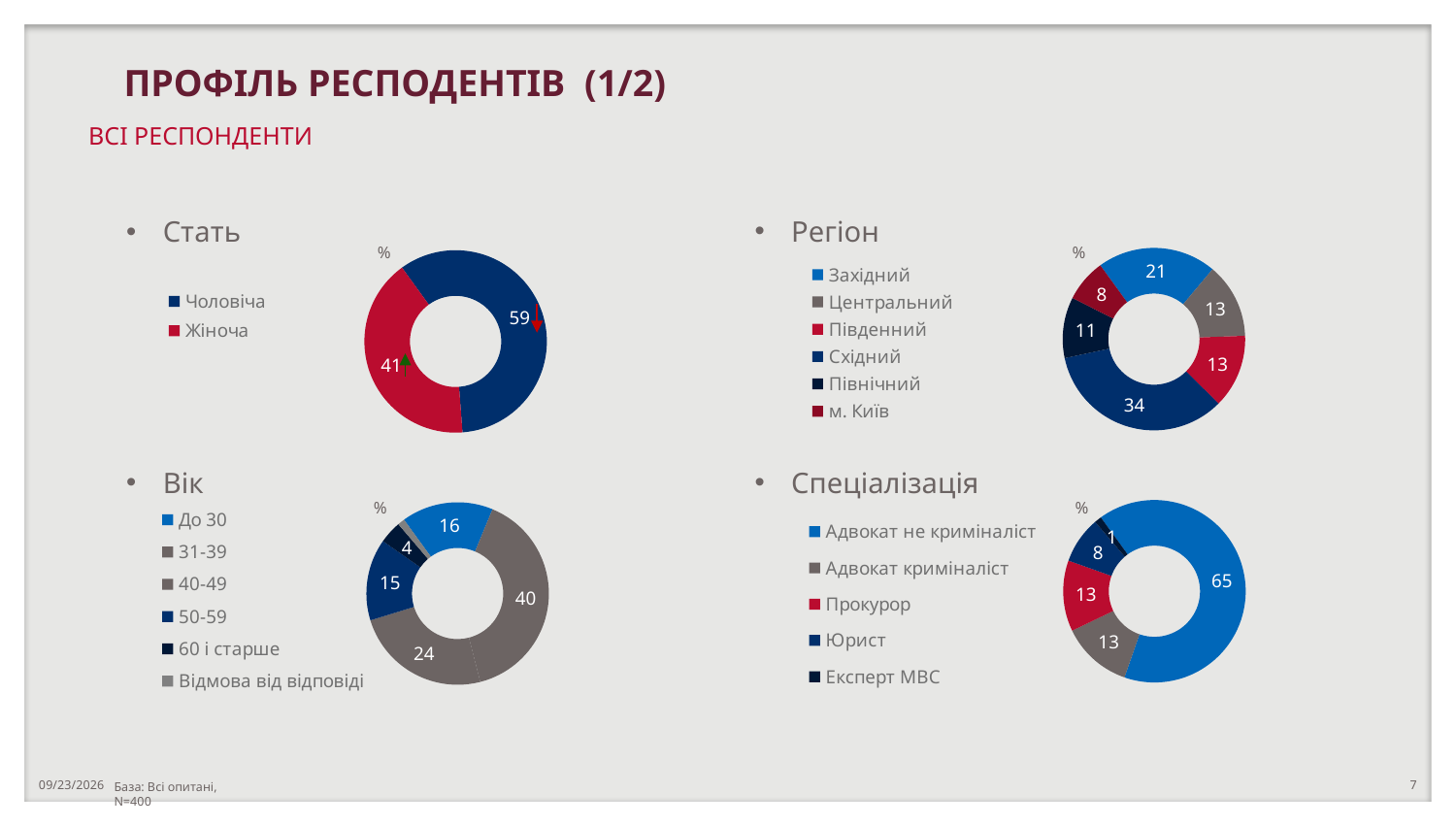
How many entries does the legend of the Вік chart list? 6 In the Регіон chart, which region has the highest share? Східний In the Вік chart, which age group has the largest share? 31-39 In the Регіон chart, what is the value for м. Київ? 8 In the Спеціалізація chart, which category has the smallest share? Експерт МВС What type of chart is used for Спеціалізація? Donut (pie) chart In the Стать chart, what is the difference between the Чоловіча and Жіноча shares? 18 In the Вік chart, what is the value for the 40-49 group? 24 In the Вік chart, which is larger: the share for До 30 or the share for 50-59? До 30 In the Стать chart, what percentage of respondents are Чоловіча? 59 In the Регіон chart, what is the difference between Східний and Західний? 13 In the Спеціалізація chart, what is the value for Адвокат не криміналіст? 65